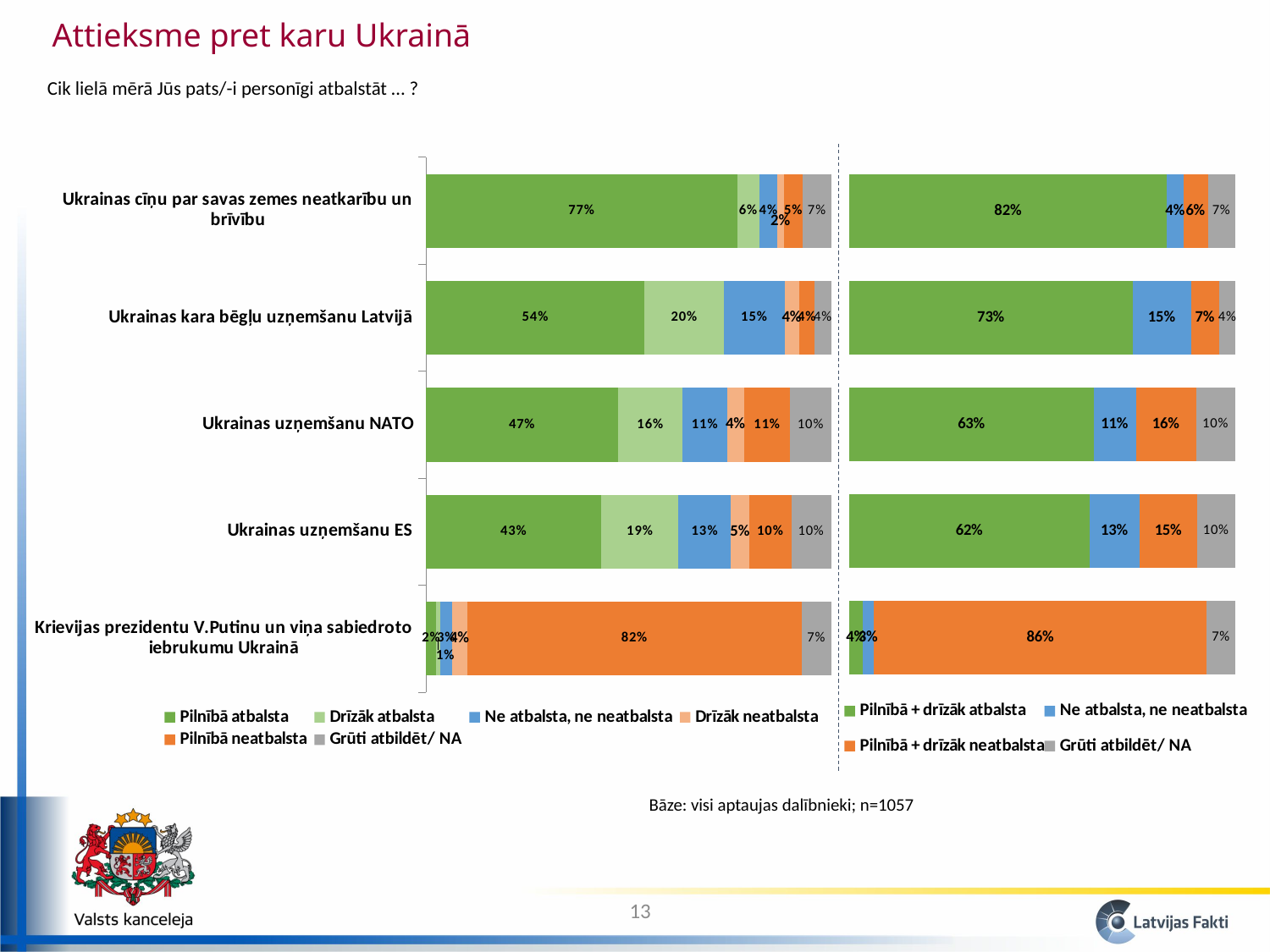
In the right chart, what is the difference between the 'Pilnībā + drīzāk atbalsta' values for Ukrainas uzņemšanu NATO and Ukrainas uzņemšanu ES? 1% In the left chart, which is larger: the 'Pilnībā atbalsta' value for Ukrainas kara bēgļu uzņemšanu Latvijā or for Ukrainas uzņemšanu NATO? Ukrainas kara bēgļu uzņemšanu Latvijā In the right chart, what is the value of 'Pilnībā + drīzāk atbalsta' for Ukrainas kara bēgļu uzņemšanu Latvijā? 73% In the left chart, what is the 'Drīzāk atbalsta' value for Ukrainas uzņemšanu ES? 19% In the left chart, which category has the lowest 'Pilnībā atbalsta' value? Krievijas prezidentu V.Putinu un viņa sabiedroto iebrukumu Ukrainā In the left chart, what percentage fully supports (Pilnībā atbalsta) Ukraine's fight for its land's independence and freedom? 77% What type of chart is the left chart? Stacked bar chart How many categories are shown in the right chart? 5 In the right chart, which category has the highest 'Pilnībā + drīzāk atbalsta' value? Ukrainas cīņu par savas zemes neatkarību un brīvību In the left chart, what is the 'Pilnībā neatbalsta' value for Krievijas prezidentu V.Putinu un viņa sabiedroto iebrukumu Ukrainā? 82% How many series does the legend of the left chart list? 6 In the right chart, what is the 'Pilnībā + drīzāk neatbalsta' value for Ukrainas uzņemšanu NATO? 16%